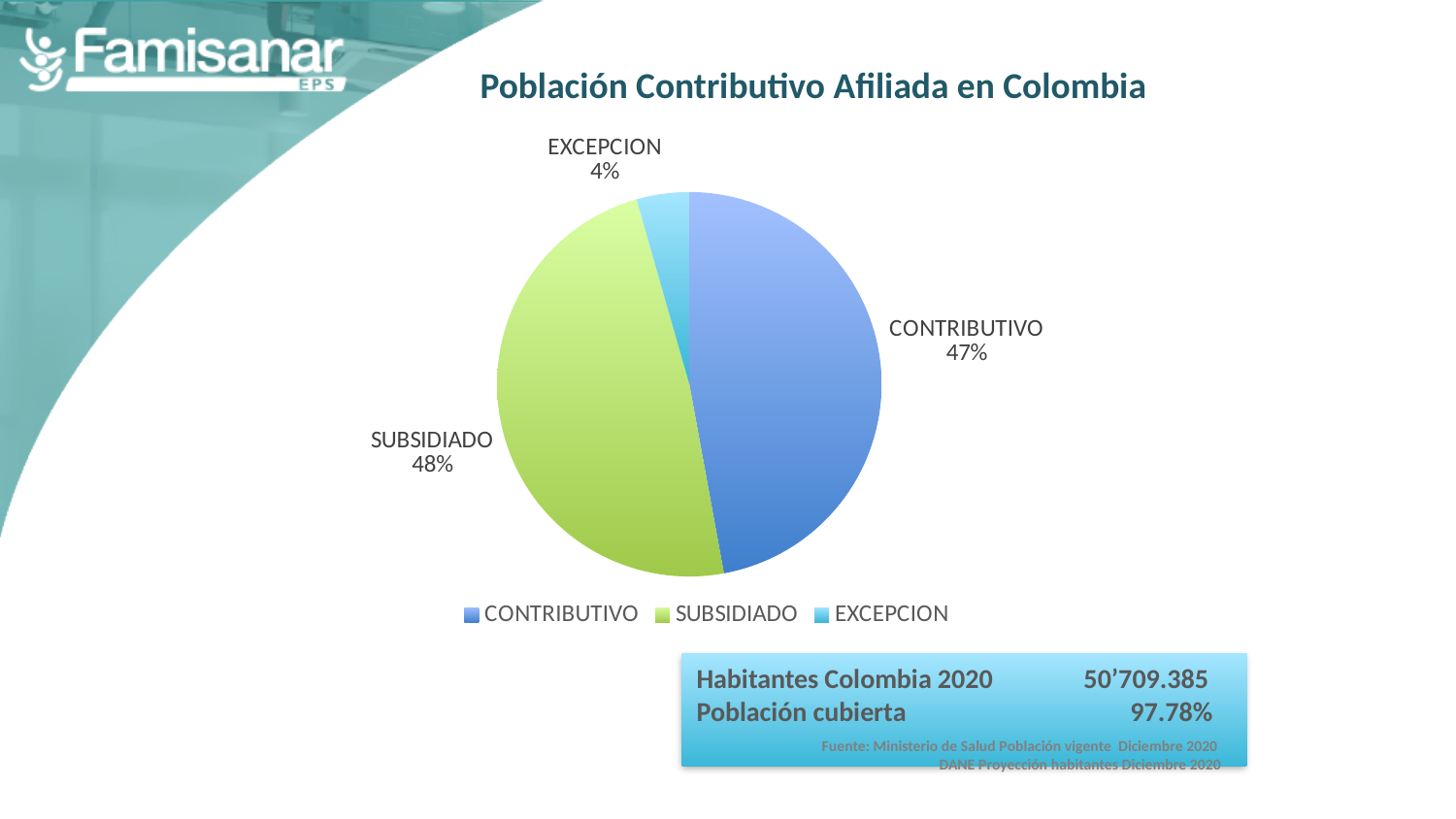
How many entries does the legend list? 3 What percentage of the pie does EXCEPCION represent? 4% What is the difference in percentage points between SUBSIDIADO and CONTRIBUTIVO? 1% What is the title of the chart? Población Contributivo Afiliada en Colombia Which is larger, the CONTRIBUTIVO slice or the SUBSIDIADO slice? SUBSIDIADO Which category has the smallest slice of the pie? EXCEPCION What is the difference in percentage points between CONTRIBUTIVO and EXCEPCION? 43% How many slices does the pie chart have? 3 Which category has the largest slice of the pie? SUBSIDIADO What percentage of the pie does CONTRIBUTIVO represent? 47% What percentage of the pie does SUBSIDIADO represent? 48% What kind of chart is shown on the slide? Pie chart